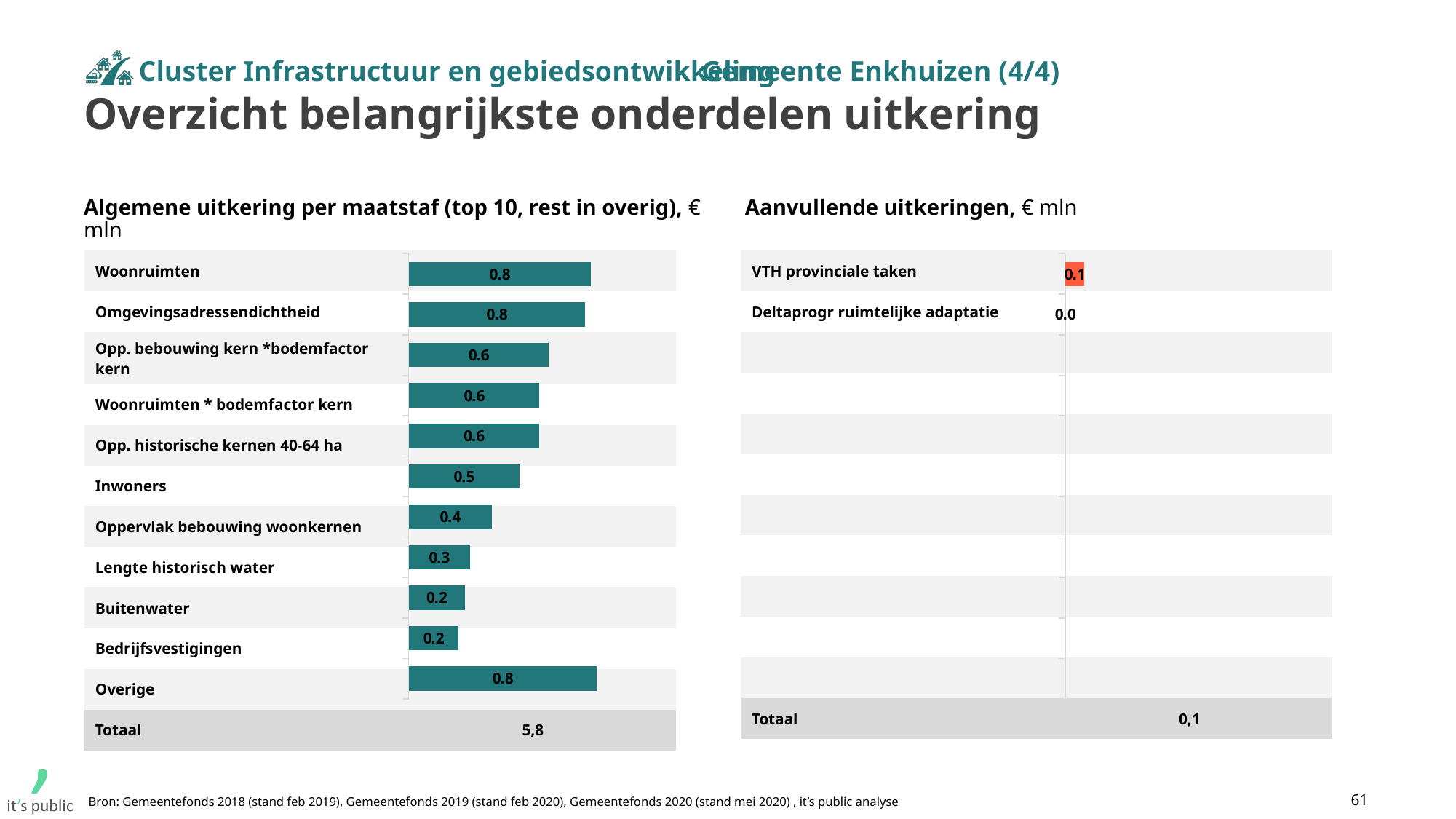
In the chart 'Algemene uitkering per maatstaf', what is the value for Inwoners? 0.5 In the chart 'Algemene uitkering per maatstaf', what is the value for Overige? 0.8 In the chart 'Algemene uitkering per maatstaf', which is larger: Inwoners or Buitenwater? Inwoners In the chart 'Aanvullende uitkeringen', what is the value for VTH provinciale taken? 0.1 How many categories (bars) are shown in the chart 'Algemene uitkering per maatstaf'? 11 In the chart 'Aanvullende uitkeringen', what is the Totaal shown at the bottom? 0,1 In the chart 'Algemene uitkering per maatstaf', what is the difference between Woonruimten and Bedrijfsvestigingen? 0.6 In the chart 'Algemene uitkering per maatstaf', what is the value for Oppervlak bebouwing woonkernen? 0.4 In the chart 'Algemene uitkering per maatstaf', what is the value for Lengte historisch water? 0.3 In the chart 'Aanvullende uitkeringen', which category has the highest value? VTH provinciale taken In the chart 'Algemene uitkering per maatstaf', what is the Totaal shown at the bottom? 5,8 What kind of chart is 'Algemene uitkering per maatstaf'? Bar chart